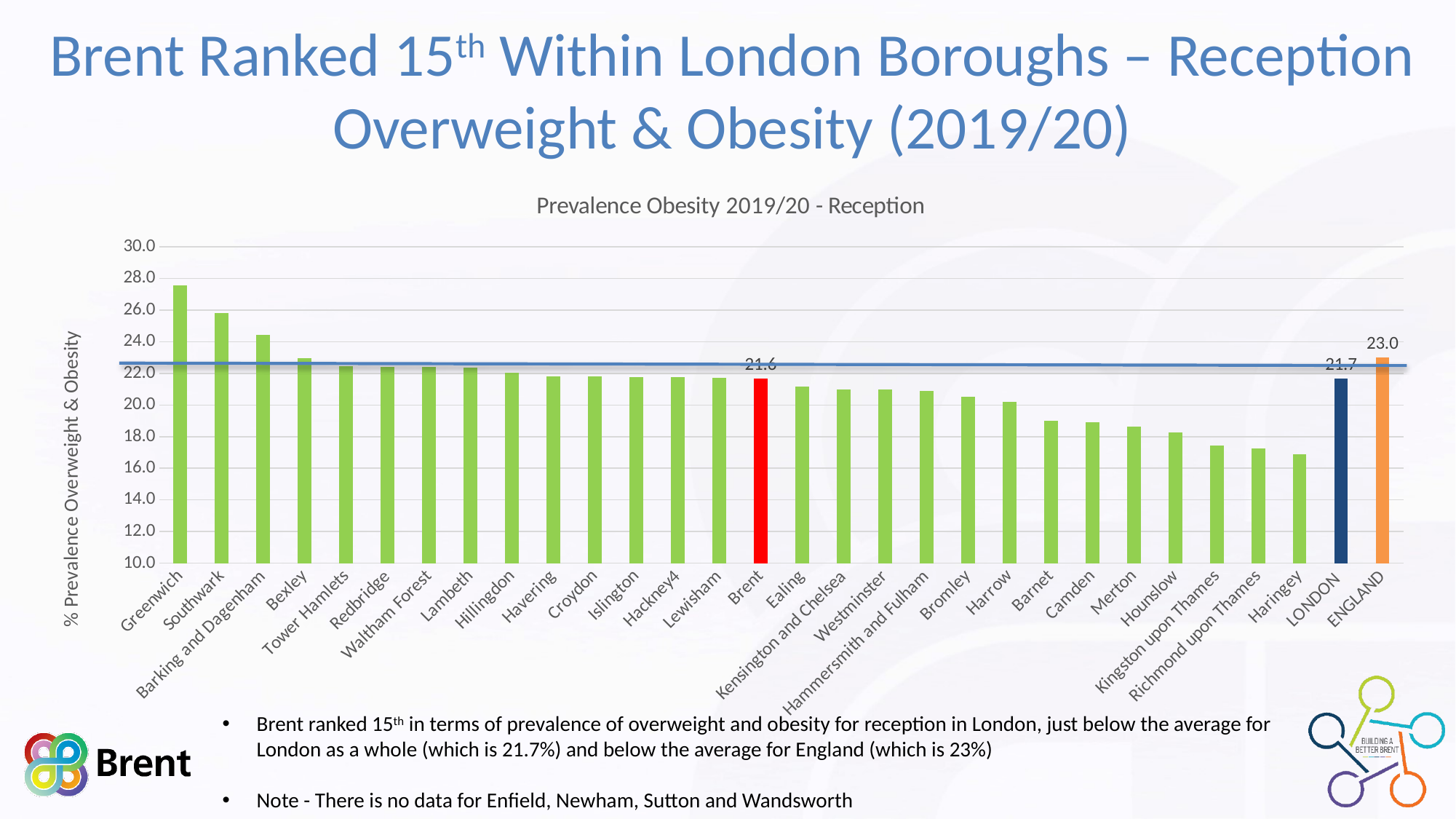
What kind of chart is this? bar chart Which borough has the lowest prevalence? Haringey What is the difference between the ENGLAND value and the Brent value? 1.4 What colour is the bar for Brent? red What is the value for ENGLAND? 23.0 Which is larger, the value for Greenwich or the value for Southwark? Greenwich What is the value for Brent? 21.6 Which borough has the highest prevalence? Greenwich What is the value for LONDON? 21.7 Is the value for Greenwich greater or less than 26.0? greater Is the value for Haringey greater or less than 18.0? less How many bars are shown in the chart? 30